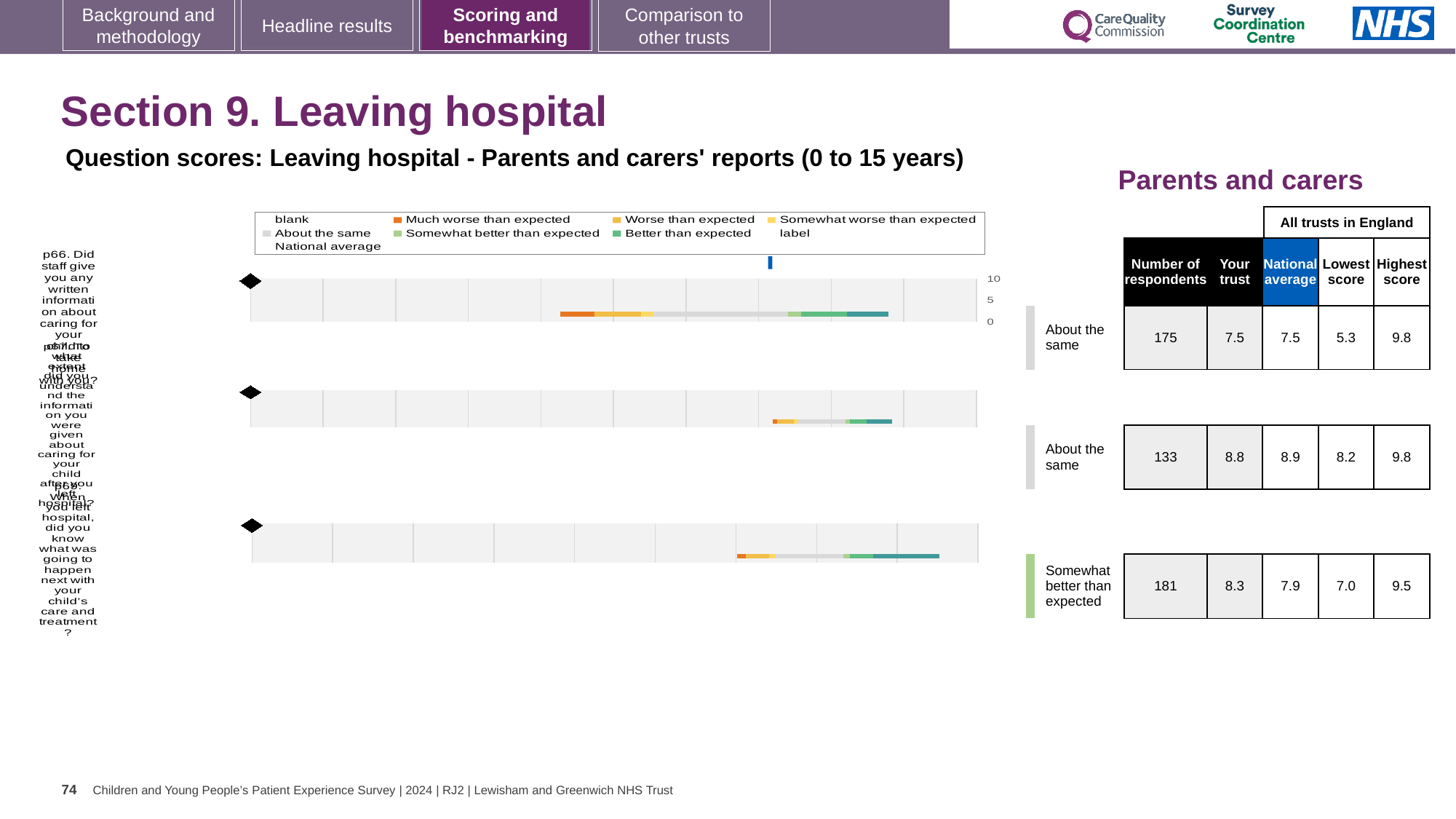
What kind of chart is used to show the question scores on this slide? bar chart In the table next to the charts, which row has the highest 'Your trust' score? the second row (About the same, 133 respondents) In the table next to the charts, what is the difference between the 'Your trust' score and the 'National average' for the 'Somewhat better than expected' row? 0.4 What is the highest value shown on the axis of the first chart? 10 In the table next to the charts, is the 'Your trust' score for the 'Somewhat better than expected' row larger or smaller than its 'National average'? larger In the table next to the charts, what is the 'Your trust' score for the row labelled 'Somewhat better than expected'? 8.3 In the table next to the charts, what is the 'Your trust' score for the first row (About the same, 175 respondents)? 7.5 How many question score bars (charts) are shown on the slide? 3 In the table next to the charts, how many respondents are in the 'Somewhat better than expected' row? 181 Which legend entry is shown in orange? Much worse than expected In the table next to the charts, what is the 'Your trust' score for the second row (About the same, 133 respondents)? 8.8 In the table next to the charts, what is the 'Lowest score' for the first row (175 respondents)? 5.3